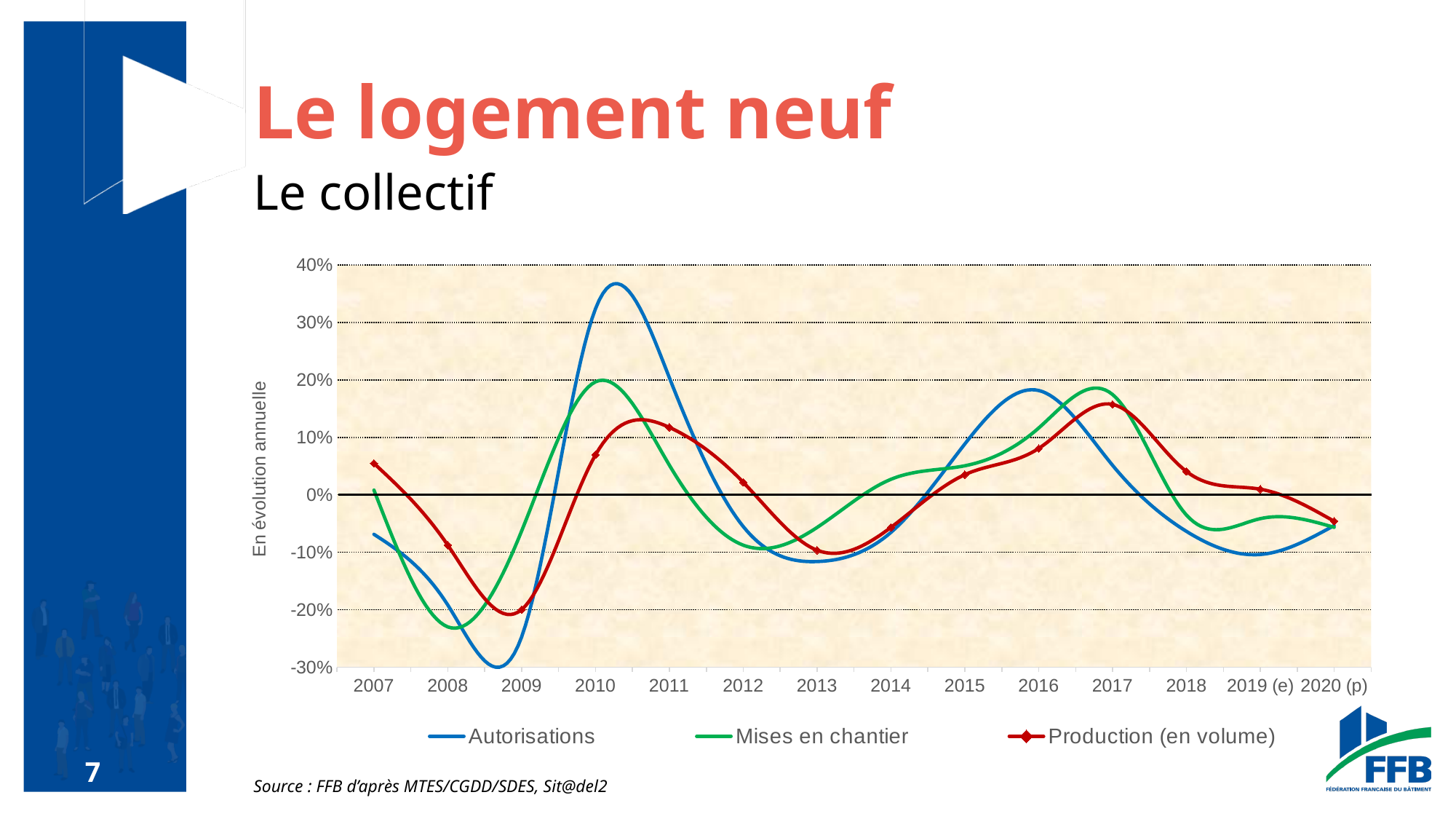
How many series does the legend list? 3 What is the label on the vertical axis of the chart? En évolution annuelle Is the value for Autorisations in 2010 greater or less than 30%? greater In 2017, which series has the larger value: Production (en volume) or Autorisations? Production (en volume) In which year does the Production (en volume) series reach its lowest value? 2009 How many years are shown along the x axis? 14 In 2010, which series has the larger value: Autorisations or Mises en chantier? Autorisations In which year does the Autorisations series reach its lowest value? 2009 Is the value for Production (en volume) in 2009 greater or less than -10%? less What kind of chart is shown on the slide? Line chart In which year does the Autorisations series reach its highest value? 2010 In which year does the Mises en chantier series reach its lowest value? 2008